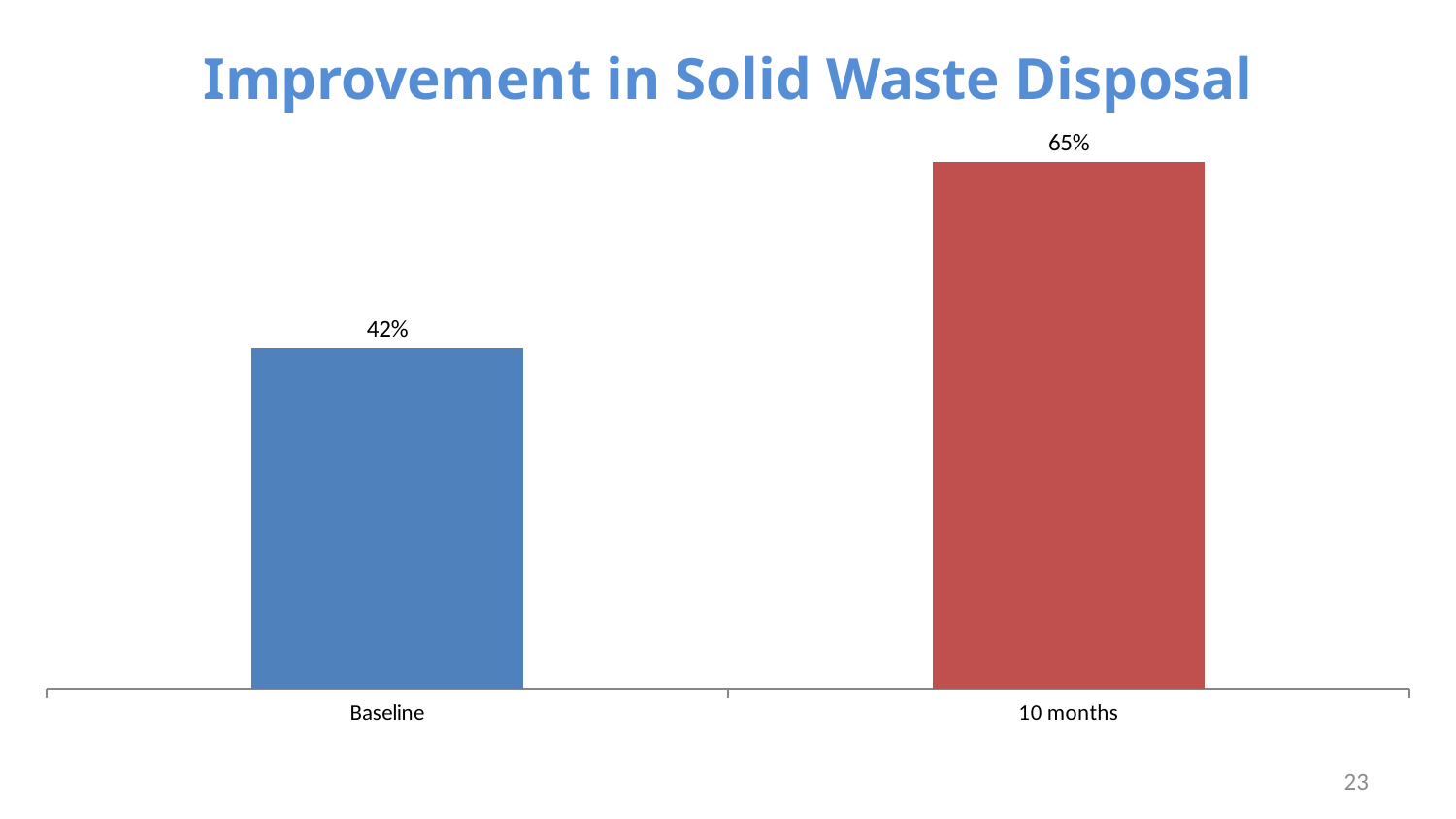
What is the title of the chart? Improvement in Solid Waste Disposal Which category has the lowest value? Baseline What colour is the bar for 10 months? Red Do the values rise or fall from Baseline to 10 months? Rise What is the value for 10 months? 65% Which category has the highest value? 10 months Which is larger, the value for Baseline or the value for 10 months? 10 months What kind of chart is shown on the slide? Bar chart How many categories are shown on the x axis? 2 What is the value for Baseline? 42% What is the difference between the 10 months value and the Baseline value? 23%